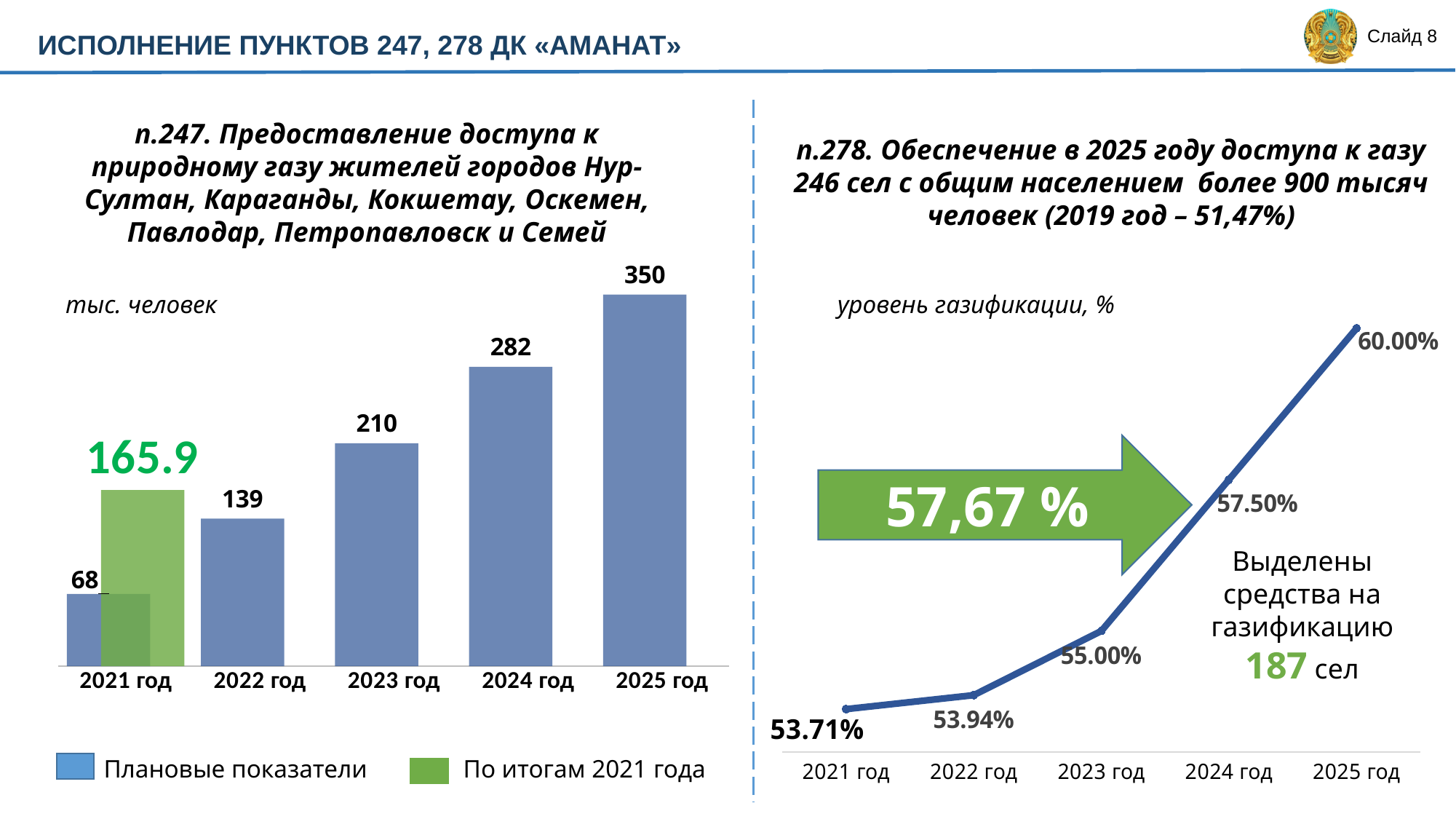
On the right chart (п.278), do the values rise or fall from 2021 год to 2025 год? rise On the left chart (п.247), what is the planned value for 2023 год? 210 On the left chart (п.247), which year has the lowest planned value? 2021 год What kind of chart is the left chart (п.247)? bar chart On the right chart (п.278), what is the value for 2021 год? 53.71% On the left chart (п.247), what is the planned value for 2025 год? 350 On the left chart (п.247), what is the value for 'По итогам 2021 года'? 165.9 On the right chart (п.278), how many years are plotted on the x axis? 5 On the right chart (п.278), what is the value for 2023 год? 55.00% On the left chart (п.247), what is the difference between the planned values for 2025 год and 2024 год? 68 On the left chart (п.247), how many series does the legend list? 2 On the left chart (п.247), which is larger for 2021 год: the planned value or the 'По итогам 2021 года' value? По итогам 2021 года